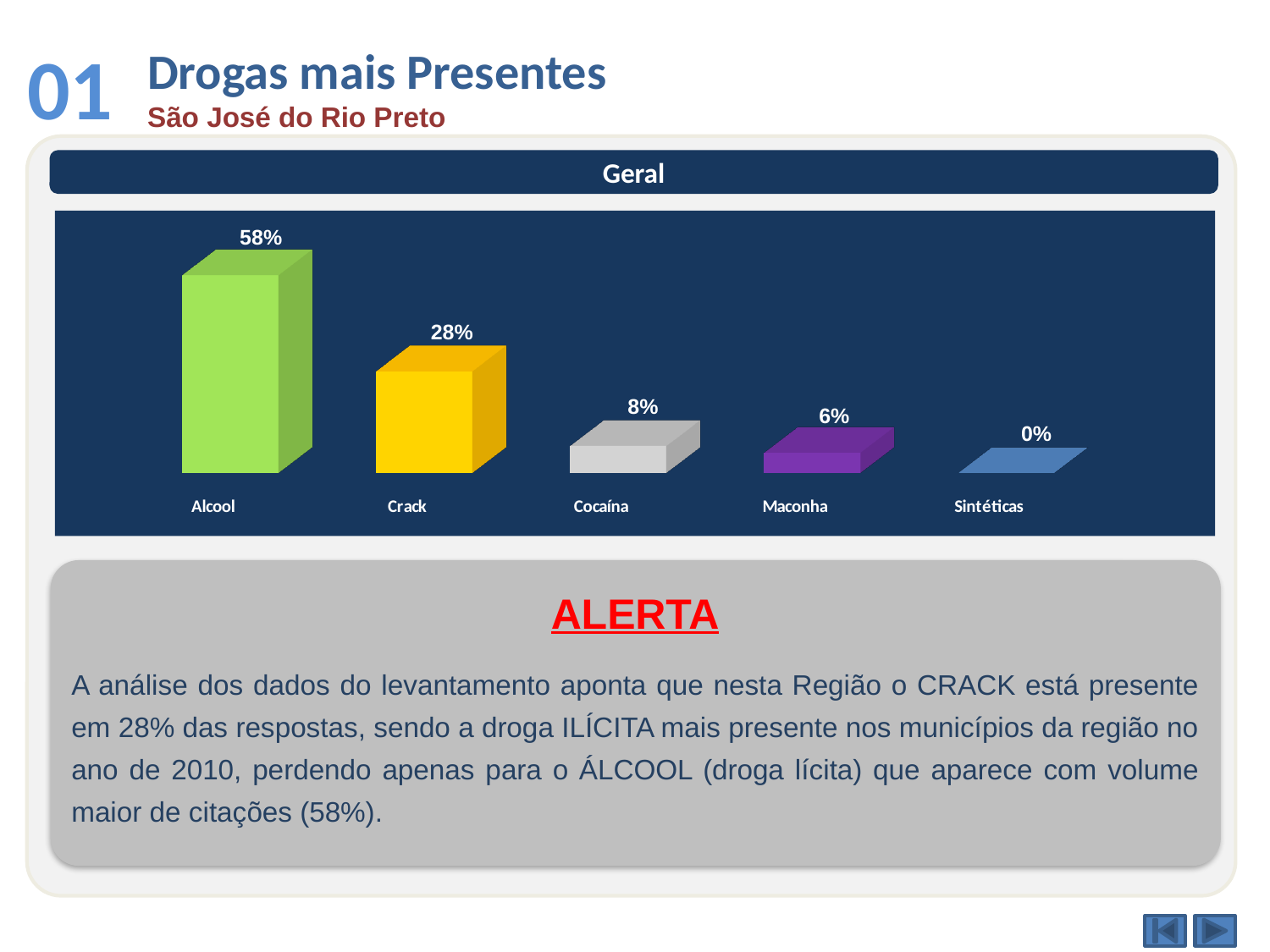
Which is larger, the value for Cocaína or the value for Maconha? Cocaína Which category has the highest value? Alcool What is the difference between the values for Alcool and Crack? 30% How many categories are shown in the chart? 5 What is the title shown above the chart? Geral Which category has the lowest value? Sintéticas What is the value for Alcool? 58% What is the value for Crack? 28% What kind of chart is shown on the slide? Bar chart What is the value for Maconha? 6% What is the value for Cocaína? 8% What is the value for Sintéticas? 0%